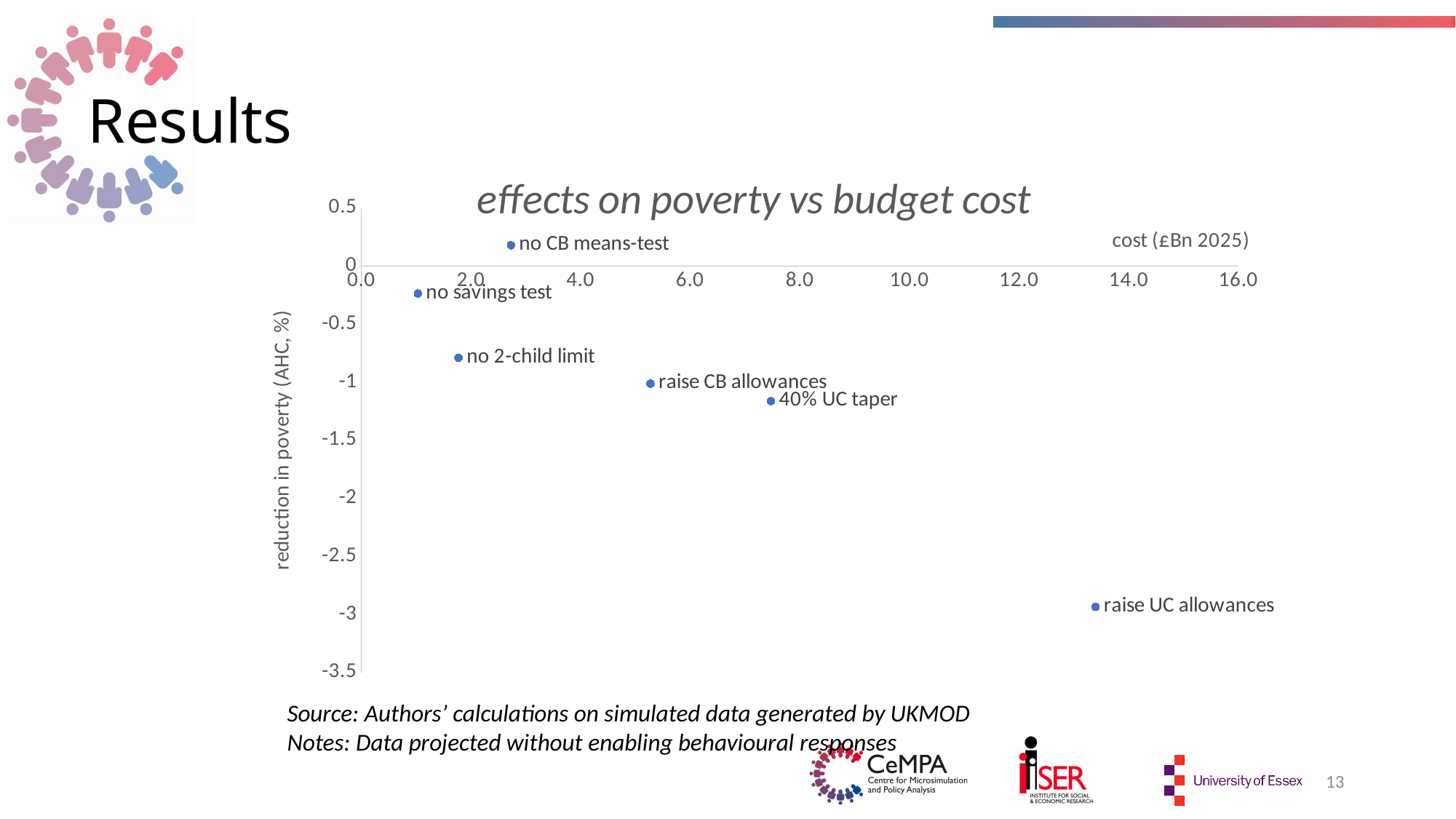
Is the reduction in poverty value for raise UC allowances greater or less than -2.5? less Which policy has the higher cost, 40% UC taper or raise CB allowances? 40% UC taper Which policy is the only one plotted above 0 on the reduction in poverty axis? no CB means-test Is the cost for raise UC allowances greater or less than 12.0? greater What kind of chart is shown on the slide? scatter chart Is the reduction in poverty value for no 2-child limit greater or less than -0.5? less What is the label of the vertical axis? reduction in poverty (AHC, %) What is the title of the chart? effects on poverty vs budget cost Which policy has the highest cost on the chart? raise UC allowances How many labelled policy points are plotted on the chart? 6 Which policy has the largest reduction in poverty (the lowest point on the chart)? raise UC allowances